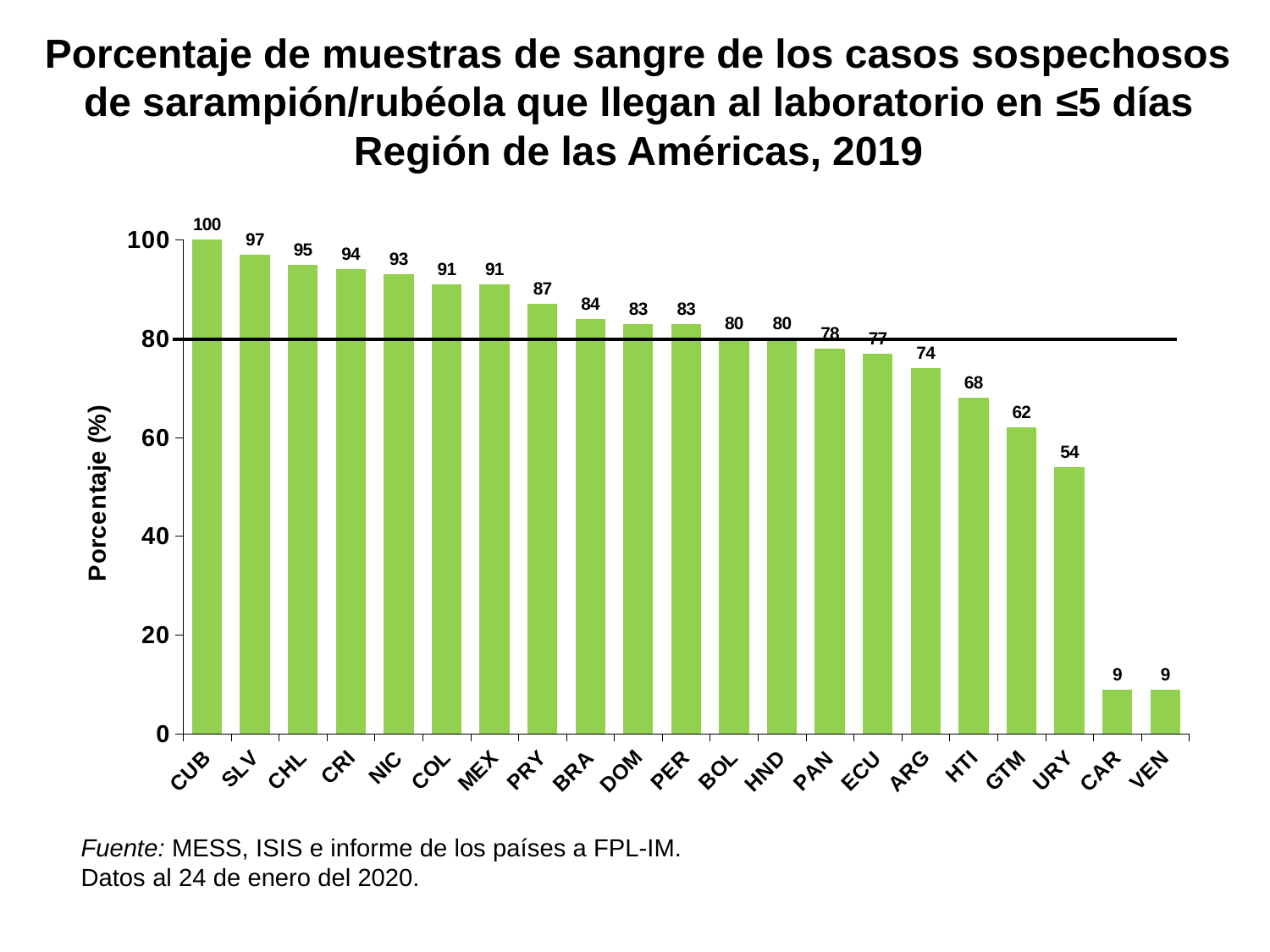
Which country has the highest value? CUB What is the difference between the values for SLV and HTI? 29 Which is larger, the value for ARG or the value for GTM? ARG Is the value for PAN greater or less than 80? less How many countries are shown on the x axis? 21 What is the label of the y axis? Porcentaje (%) What is the value for URY? 54 What kind of chart is this? bar chart Do the values rise or fall from left to right along the x axis? fall At what value is the horizontal black reference line drawn? 80 What is the value for CUB? 100 What is the value for PRY? 87